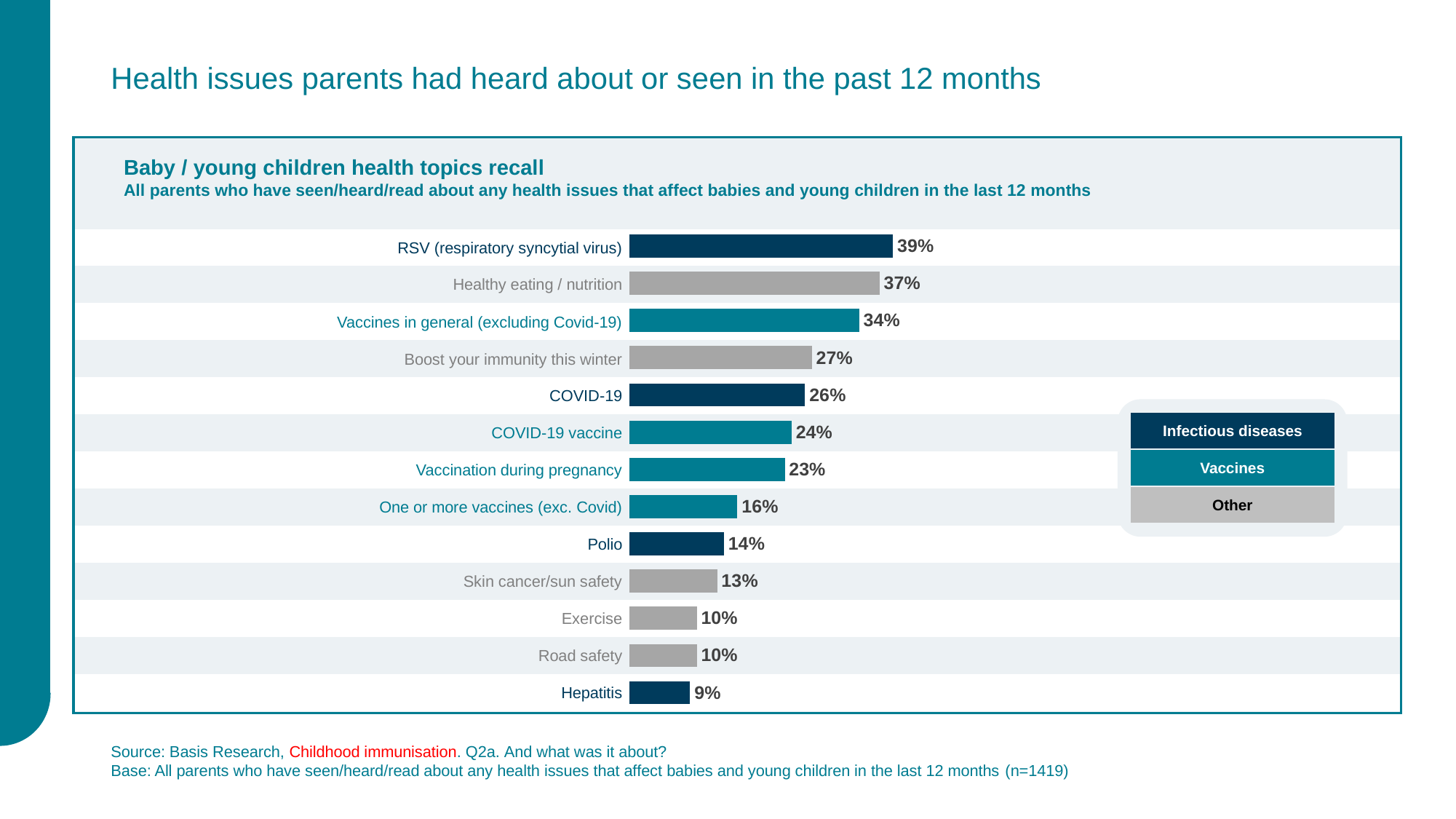
What is the difference between Vaccines in general (excluding Covid-19) and One or more vaccines (exc. Covid)? 18% Which health topic has the highest recall? RSV (respiratory syncytial virus) What is the difference between the values for Healthy eating / nutrition and COVID-19? 11% Which is larger, the value for COVID-19 vaccine or the value for Polio? COVID-19 vaccine Which legend category does the Boost your immunity this winter bar belong to? Other How many categories does the legend list? 3 Which health topic has the lowest recall? Hepatitis What percentage of parents recalled RSV (respiratory syncytial virus)? 39% What percentage is shown for Skin cancer/sun safety? 13% How many health topics are listed in the chart? 13 What is the value for Vaccination during pregnancy? 23% What type of chart is shown on the slide? Bar chart